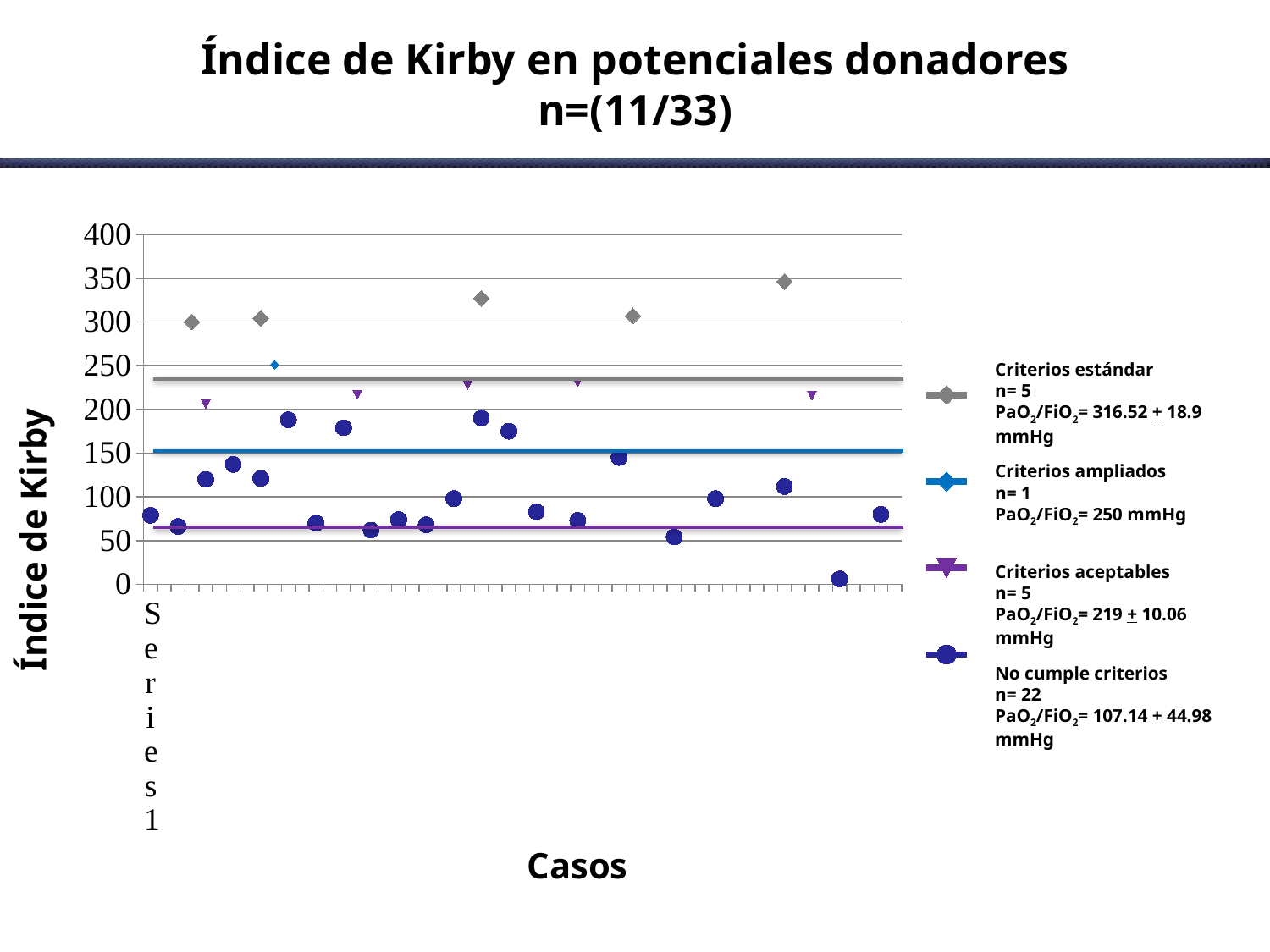
What is the PaO2/FiO2 value for the single 'Criterios ampliados' case? 250 mmHg Is the highest 'Criterios estándar' point greater or less than 300? greater Which series contains the lowest plotted point? No cumple criterios Is the lowest 'No cumple criterios' point greater or less than 50? less Which series contains the highest plotted points? Criterios estándar What is the label of the x axis? Casos What kind of chart is shown on the slide? Scatter chart According to the legend, how many cases are in the 'No cumple criterios' series? 22 According to the legend, how many cases are in the 'Criterios estándar' series? 5 What is the title of the chart? Índice de Kirby en potenciales donadores n=(11/33) Are the 'Criterios aceptables' points greater or less than 250? less How many series does the legend list? 4